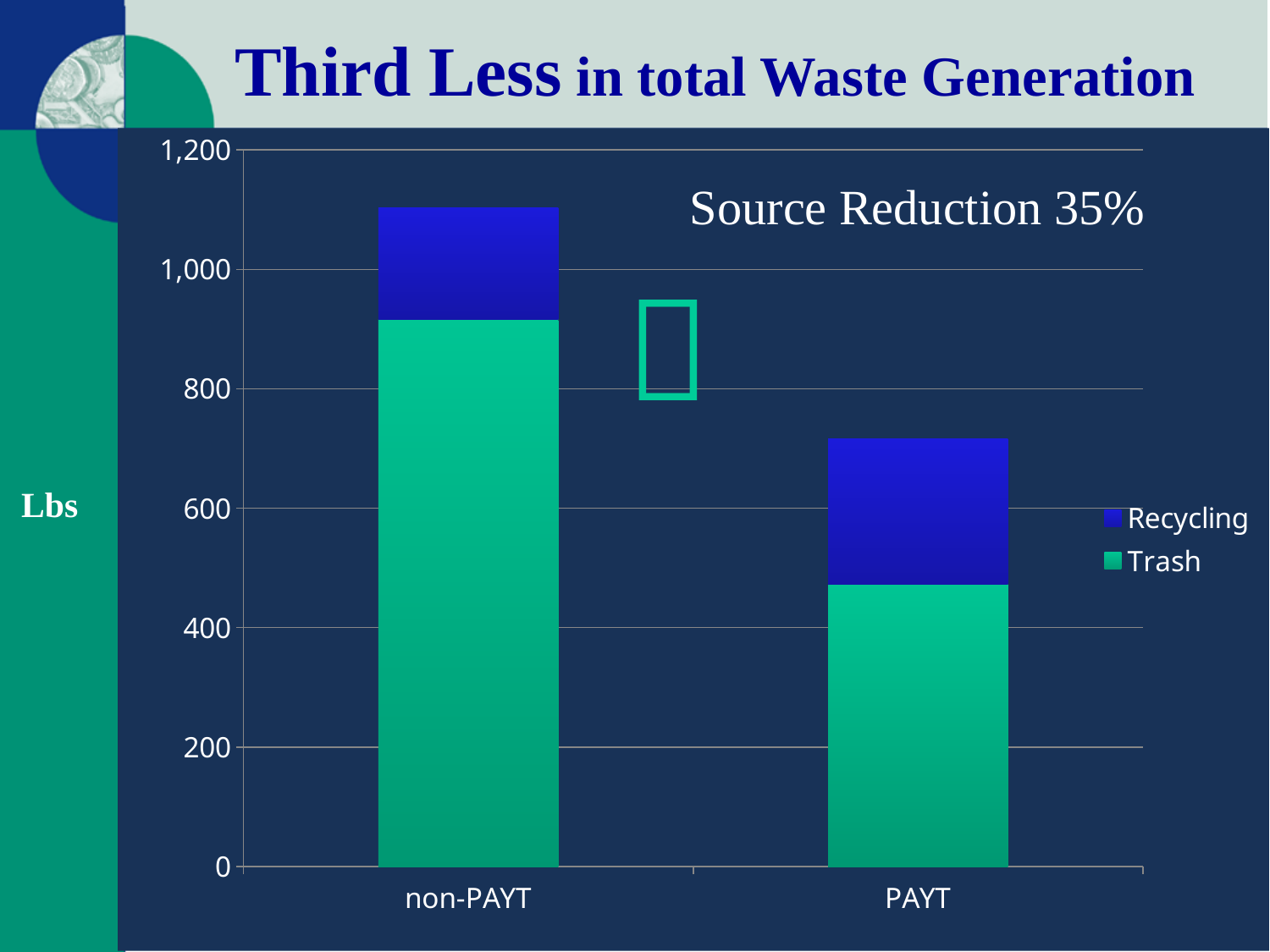
Which category has the larger Recycling segment, non-PAYT or PAYT? PAYT What source reduction percentage is stated on the chart? 35% Which category has the lowest total waste in the chart? PAYT Is the total bar for PAYT greater or less than 800? less What unit label is shown beside the y axis of the chart? Lbs Is the total bar for non-PAYT greater or less than 1,000? greater How many categories are shown on the x axis of the chart? 2 What kind of chart is shown on the slide? stacked bar chart Is the Trash value for non-PAYT greater or less than 800? greater Which category has the taller total bar, non-PAYT or PAYT? non-PAYT How many series does the chart legend list? 2